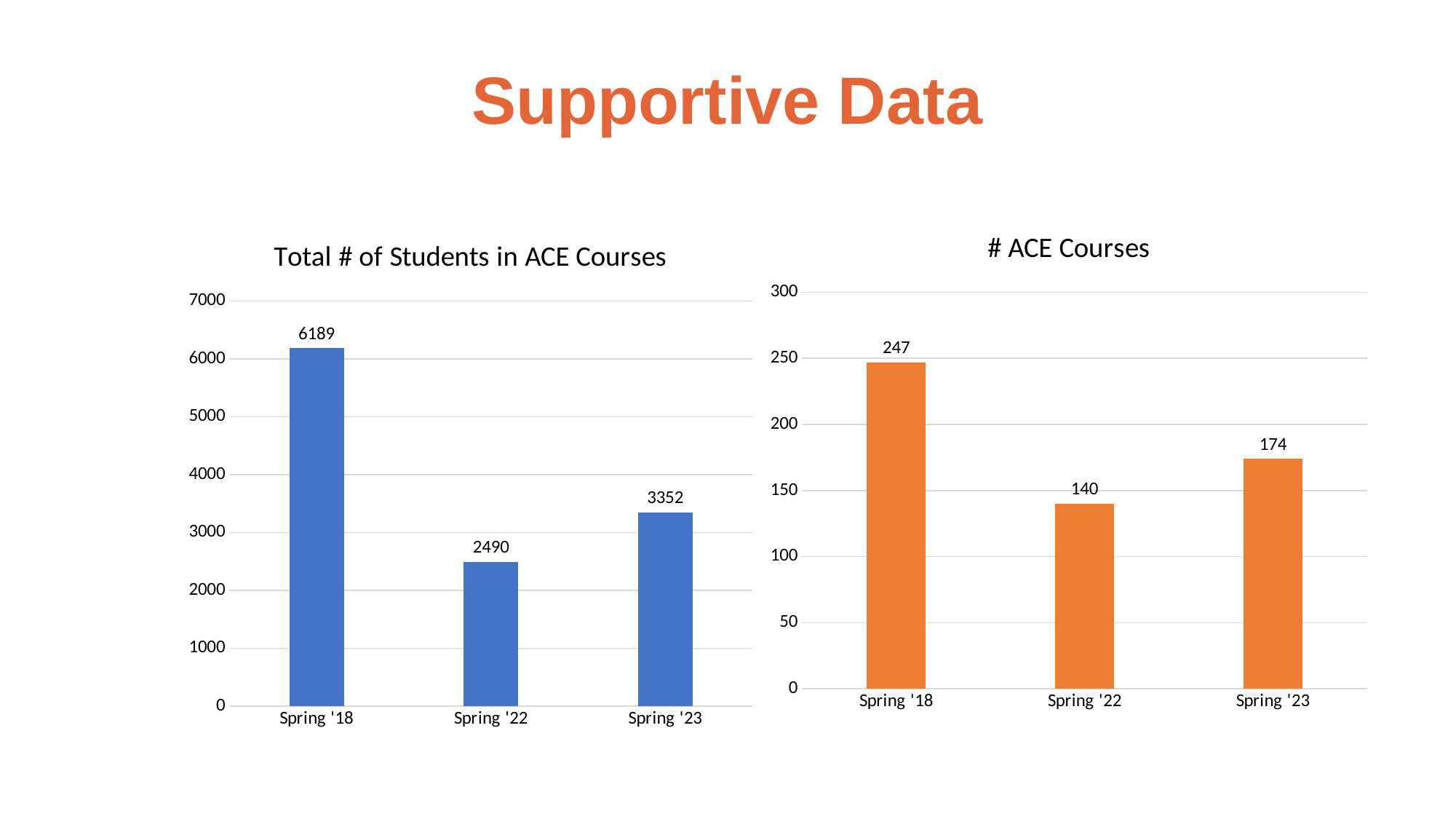
In the 'Total # of Students in ACE Courses' chart, what is the value for Spring '18? 6189 In the 'Total # of Students in ACE Courses' chart, what is the value for Spring '22? 2490 In the '# ACE Courses' chart, which is larger, the value for Spring '22 or Spring '23? Spring '23 What colour are the bars in the '# ACE Courses' chart? orange What kind of chart is the 'Total # of Students in ACE Courses' chart? bar chart In the 'Total # of Students in ACE Courses' chart, what is the difference between the values for Spring '23 and Spring '22? 862 In the 'Total # of Students in ACE Courses' chart, which category has the highest value? Spring '18 How many categories are shown in the '# ACE Courses' chart? 3 In the '# ACE Courses' chart, what is the value for Spring '23? 174 In the 'Total # of Students in ACE Courses' chart, is the value for Spring '23 greater or less than 3000? greater In the '# ACE Courses' chart, which category has the lowest value? Spring '22 In the '# ACE Courses' chart, what is the difference between the values for Spring '18 and Spring '22? 107